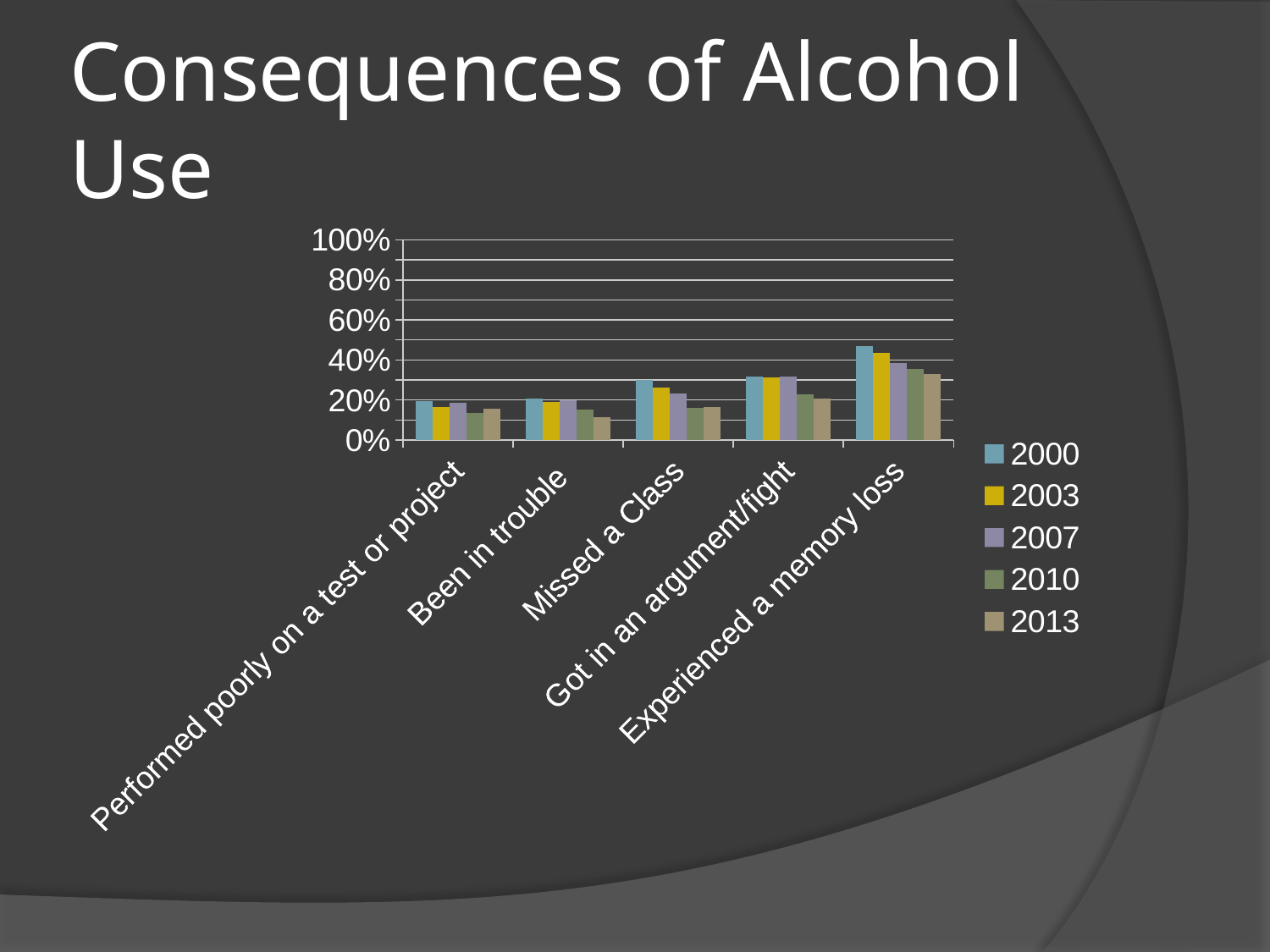
Is the 2000 value for Experienced a memory loss greater or less than 40%? greater Is the 2013 value for Been in trouble greater or less than 20%? less How many series does the legend list? 5 Which category has the lowest value for 2013? Been in trouble Which category has the highest value for 2000? Experienced a memory loss What is the title of the slide containing the chart? Consequences of Alcohol Use Which is larger for 2000: Experienced a memory loss or Performed poorly on a test or project? Experienced a memory loss What kind of chart is shown on the slide? bar chart How many categories are shown on the x axis? 5 For Experienced a memory loss, do the values rise or fall from 2000 to 2013? fall For Missed a Class, which year has the larger value, 2000 or 2013? 2000 Is the 2000 value for Missed a Class greater or less than 20%? greater